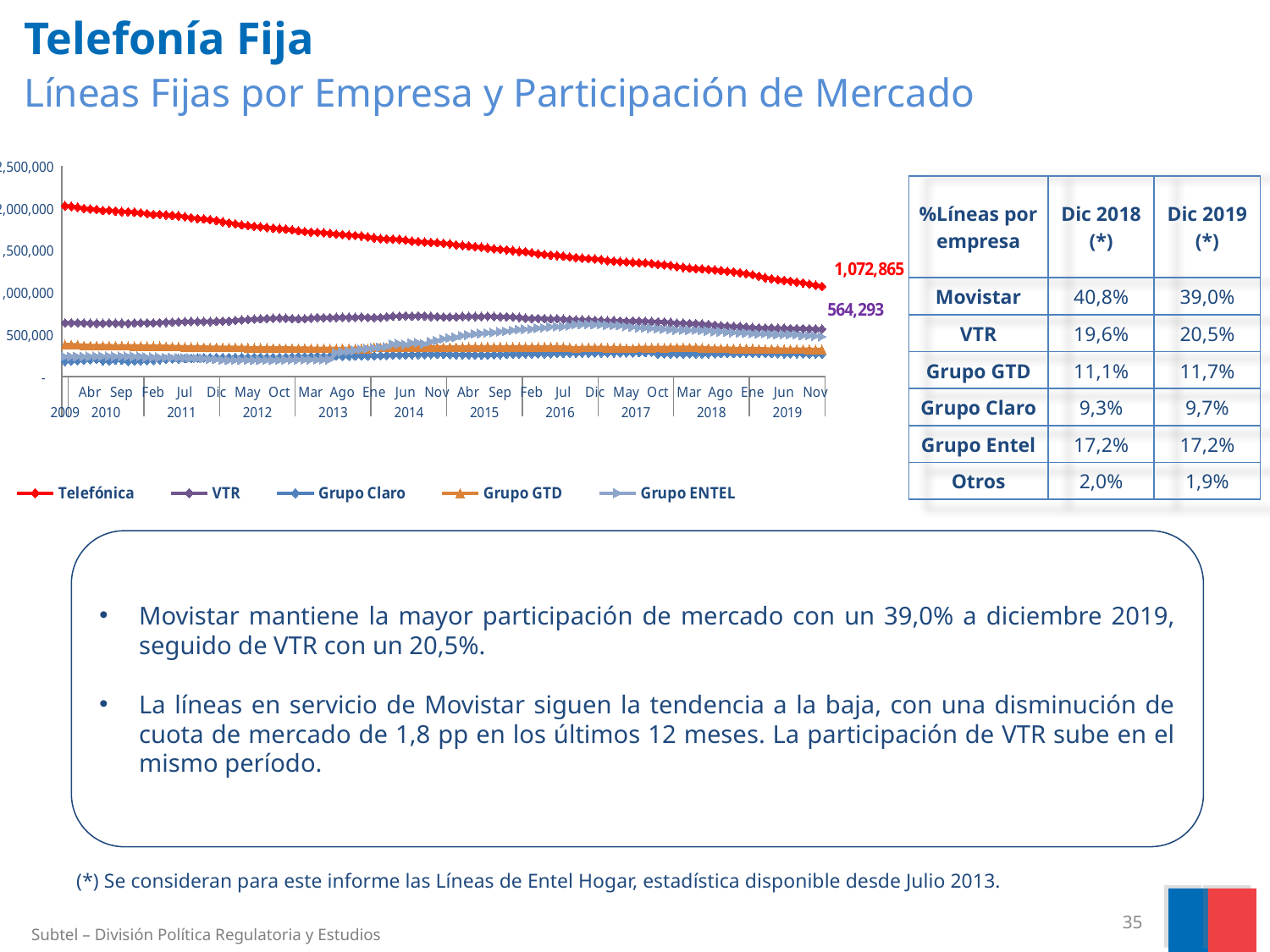
What kind of chart is shown on the slide? line chart What is the labelled value for Telefónica at the end of the series in 2019? 1,072,865 Does the Telefónica line rise or fall from 2009 to 2019? fall Is the value for Grupo GTD at the end of 2019 greater or less than 500,000? less Which series has the highest values throughout the chart? Telefónica Is the value for Telefónica at the end of 2019 greater or less than 1,000,000? greater Which is larger at the end of 2019, the Telefónica line or the VTR line? Telefónica How many series does the chart legend list? 5 Which colour is used for the Telefónica series in the chart? red What is the labelled value for VTR at the end of the series in 2019? 564,293 What is the difference between the labelled end values for Telefónica (1,072,865) and VTR (564,293)? 508,572 Does the Grupo ENTEL line rise or fall from 2013 to 2016? rise